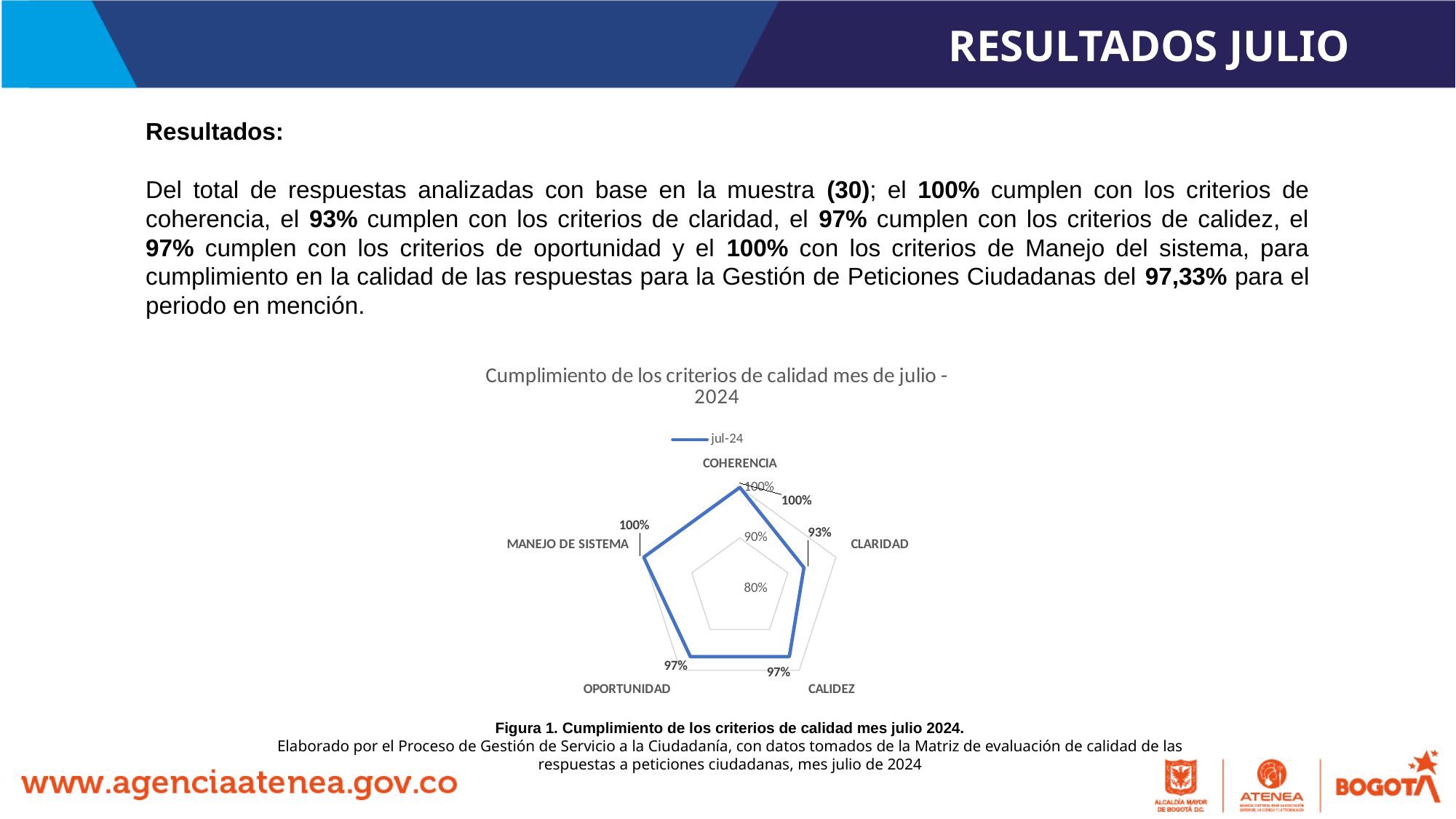
How many categories (axes) does the radar chart have? 5 How many series does the chart legend list? 1 What is the value for CALIDEZ in the chart? 97% Which is larger, the value for CALIDEZ or the value for CLARIDAD? CALIDEZ Is the value for CLARIDAD greater or less than 90%? greater What is the name of the series shown in the chart legend? jul-24 Which category has the lowest value in the chart? CLARIDAD What is the value for MANEJO DE SISTEMA in the chart? 100% What is the value for OPORTUNIDAD in the chart? 97% What kind of chart is shown on the slide? Radar chart What is the value for CLARIDAD in the chart? 93% What is the difference between the values for COHERENCIA and CLARIDAD? 7%